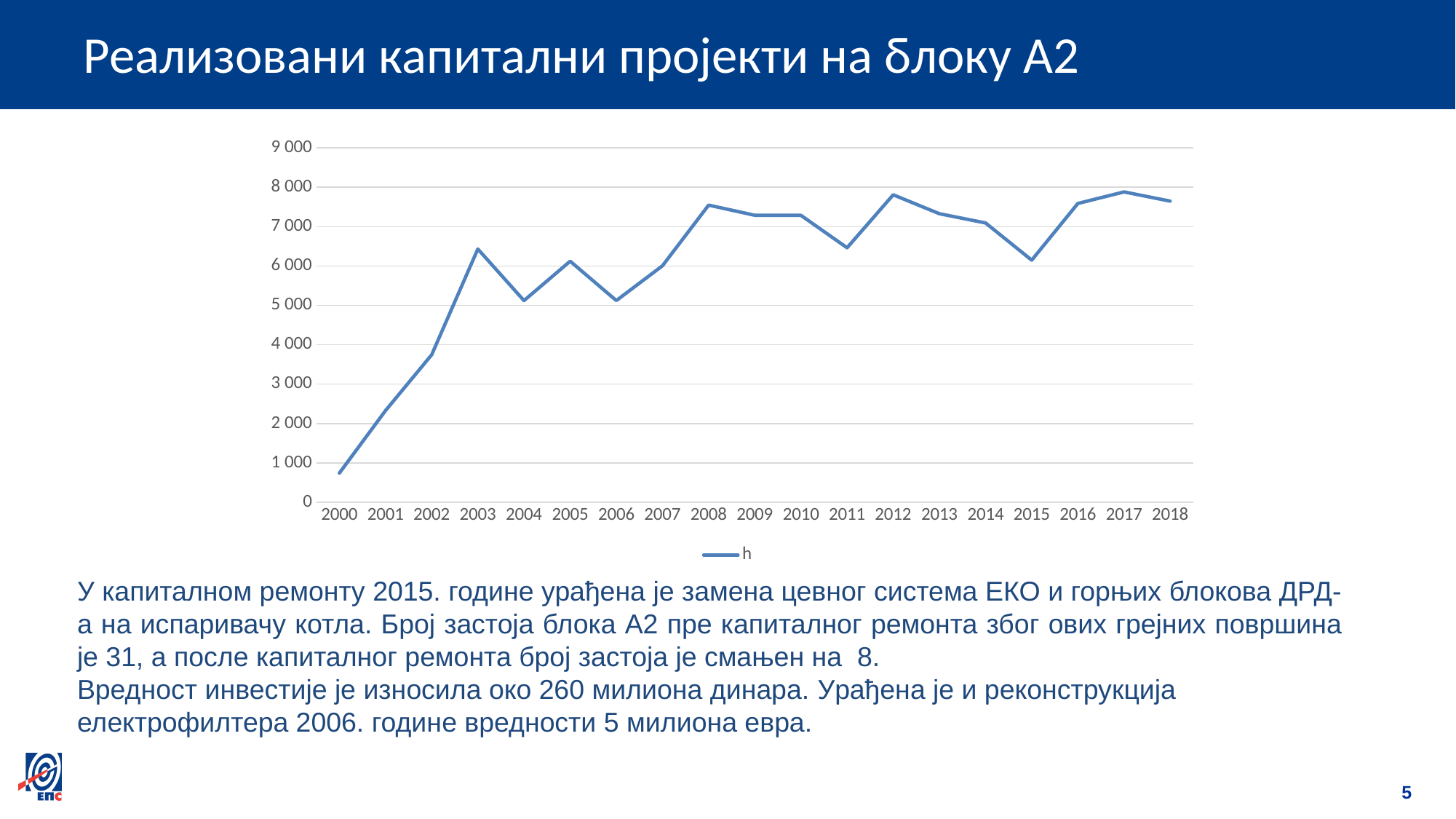
Do the values rise or fall from 2000 to 2003? rise What kind of chart is shown on the slide? line chart Is the value for 2008 greater or less than 7 000? greater Is the value for 2015 greater or less than 7 000? less Is the value for 2000 greater or less than 1 000? less How many years are plotted along the x axis of the chart? 19 How many series does the chart legend list? 1 Which year has the lowest value in the chart? 2000 What is the name of the series shown in the chart legend? h Which year has the larger value, 2003 or 2004? 2003